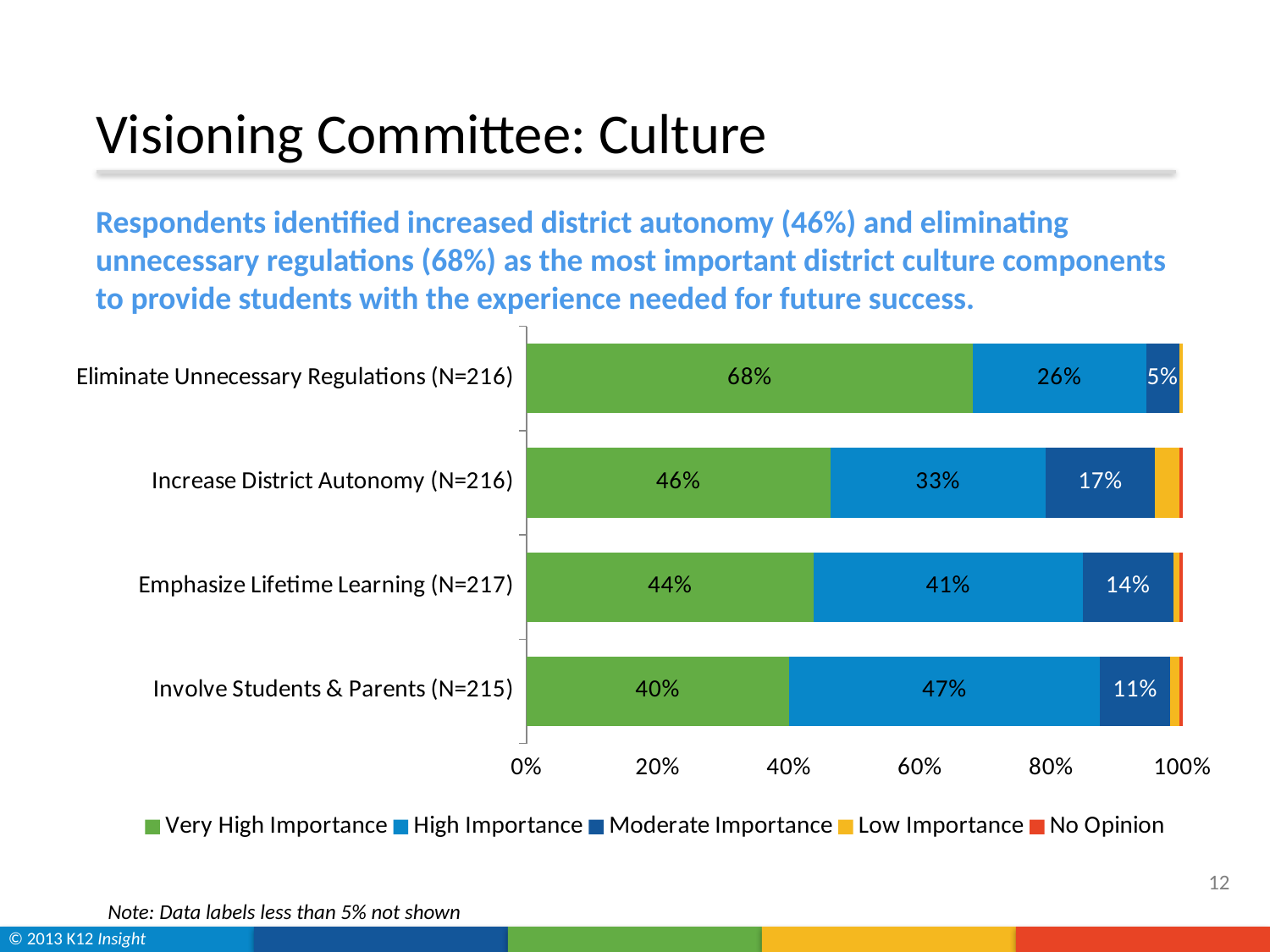
What is the difference between the Very High Importance values for Eliminate Unnecessary Regulations (N=216) and Increase District Autonomy (N=216)? 22% What kind of chart is shown on the slide? Stacked bar chart How many categories are plotted in the chart? 4 What is the Very High Importance value for Eliminate Unnecessary Regulations (N=216)? 68% What is the High Importance value for Involve Students & Parents (N=215)? 47% What is the Moderate Importance value for Increase District Autonomy (N=216)? 17% Which category has the highest Very High Importance value? Eliminate Unnecessary Regulations (N=216) Which is larger for Emphasize Lifetime Learning (N=217): the Very High Importance value or the High Importance value? Very High Importance How many series does the legend list? 5 Is the Very High Importance value for Involve Students & Parents (N=215) greater or less than 60%? less Which category has the lowest Very High Importance value? Involve Students & Parents (N=215) Which legend entry is shown in green? Very High Importance